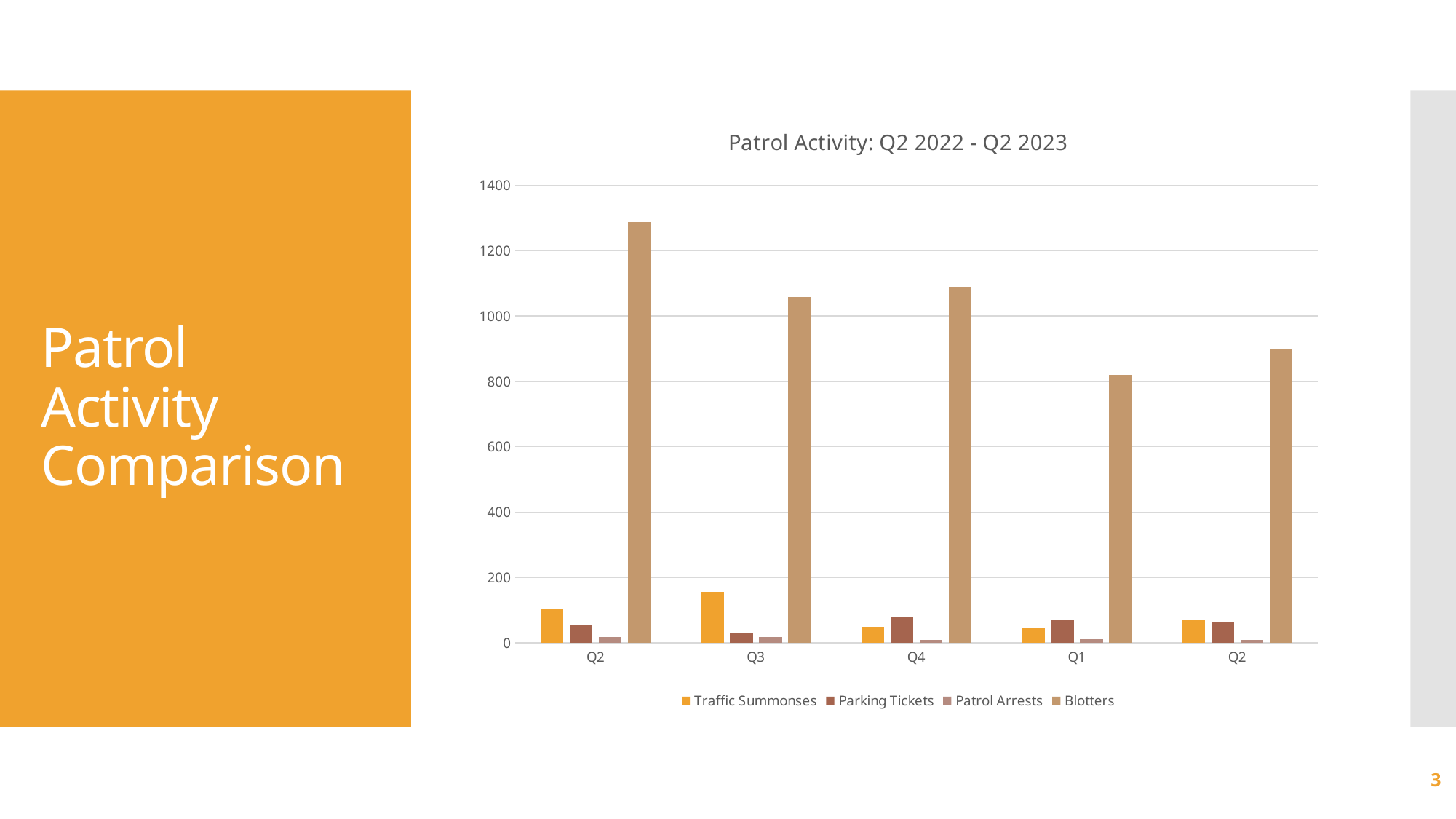
Which is larger, the Traffic Summonses value for Q3 or for the first Q2? Q3 Which series has the tallest bars in every quarter? Blotters What kind of chart is shown on the slide? bar chart Is the Blotters value for the first Q2 greater or less than 1200? greater How many quarter categories are shown on the x axis? 5 In which quarter is the Blotters value lowest? Q1 Is the Blotters value for Q1 greater or less than 1000? less In which quarter is the Blotters value highest? Q2 (the first Q2) How many series does the legend list? 4 In which quarter is the Traffic Summonses value highest? Q3 What is the title of the chart? Patrol Activity: Q2 2022 - Q2 2023